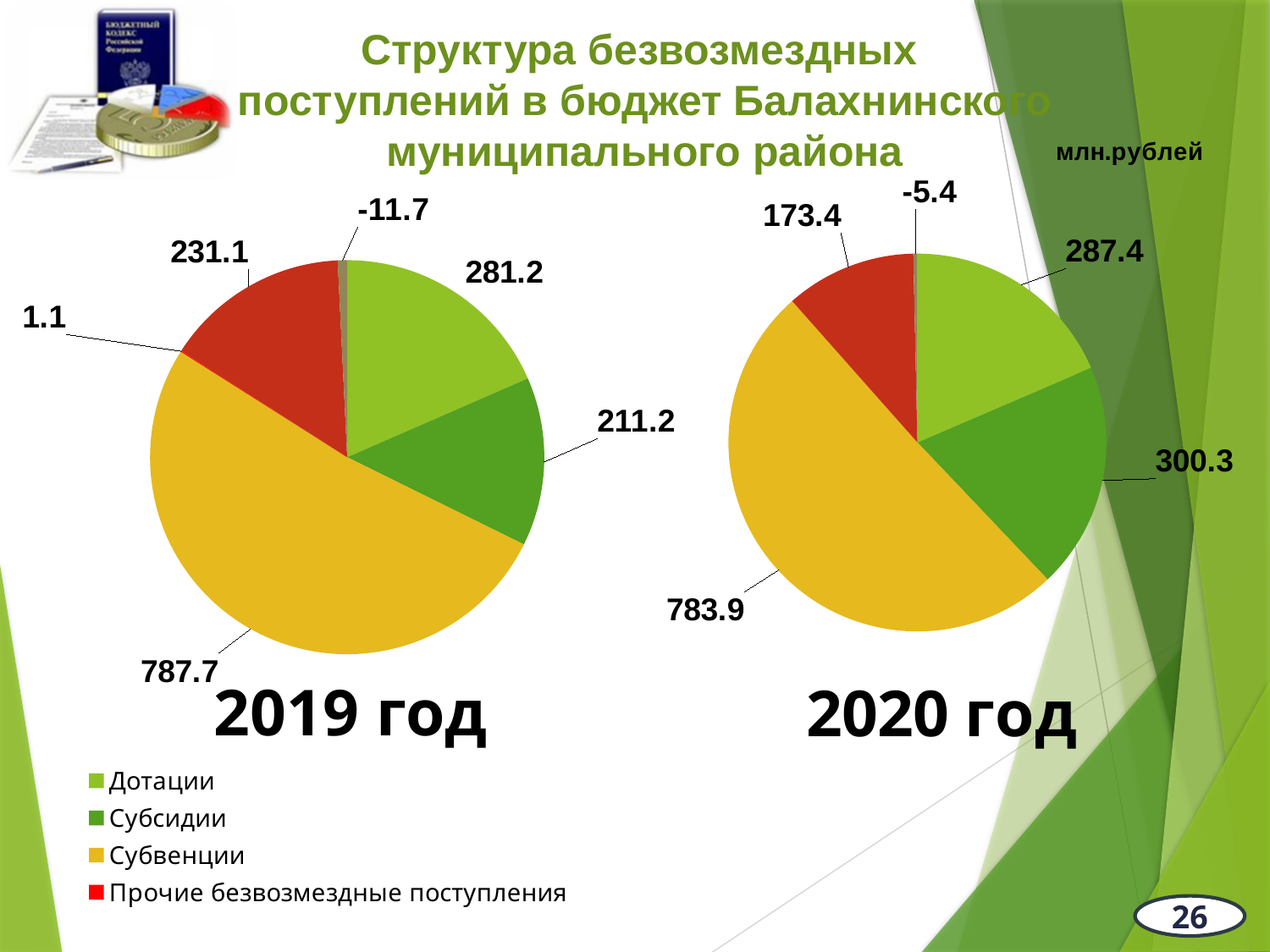
Which is larger: Субвенции in the 2019 год chart or Субвенции in the 2020 год chart? 2019 год In the 2020 год pie chart, which is larger: Субсидии or Дотации? Субсидии How many categories does the legend list? 4 In the 2020 год pie chart, what is the difference between Субсидии and Дотации? 12.9 In the 2019 год pie chart, what is the difference between Субвенции and Дотации? 506.5 In the 2020 год pie chart, what is the value for Дотации? 287.4 In the 2019 год pie chart, which legend category has the largest slice? Субвенции In the 2020 год pie chart, which legend category has the largest slice? Субвенции In the 2019 год pie chart, what is the value for Прочие безвозмездные поступления? 1.1 In the 2019 год pie chart, what is the value for Субвенции? 787.7 What type of chart is used for the 2019 год and 2020 год data? Pie chart In the 2020 год pie chart, what is the value for Субсидии? 300.3